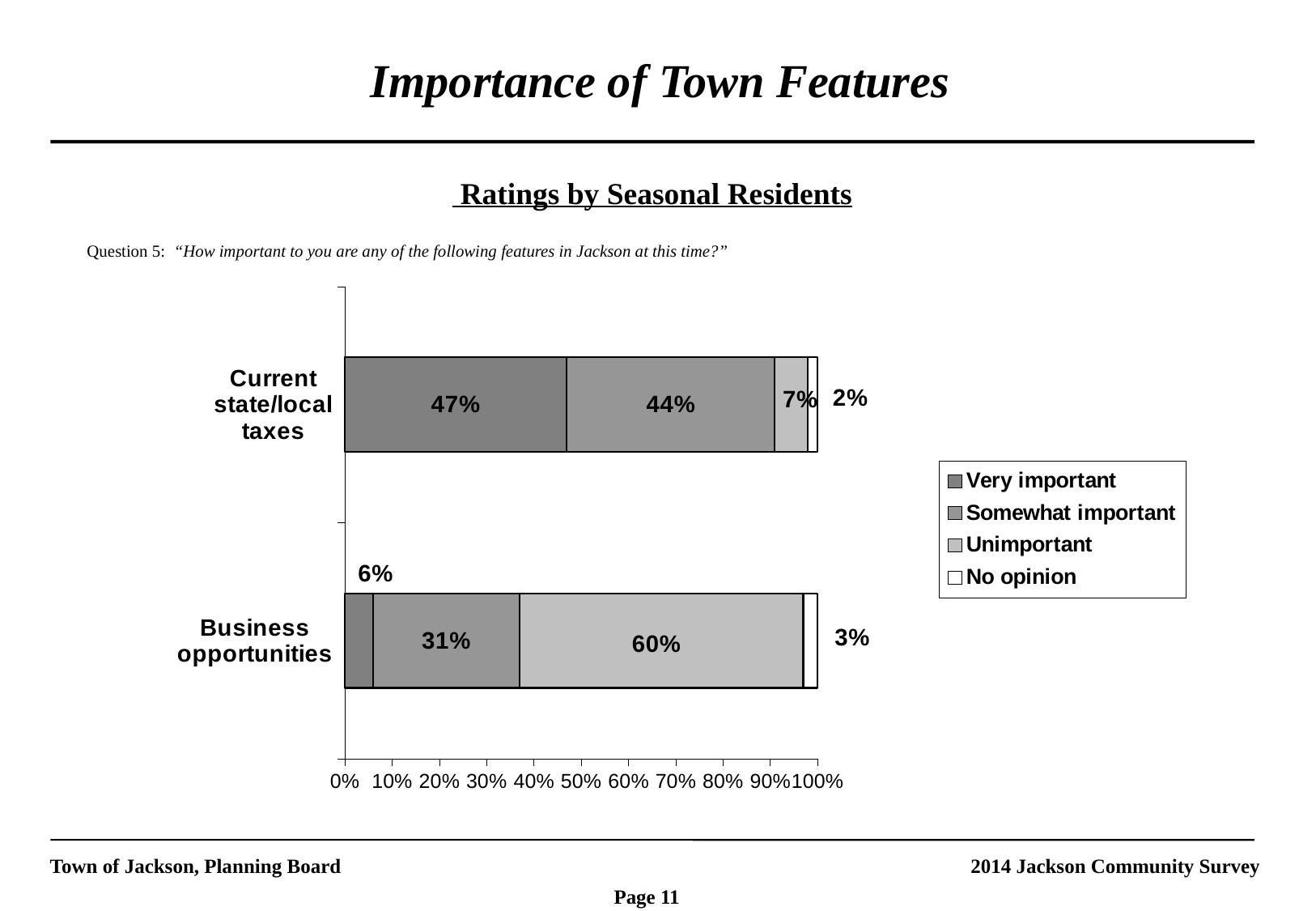
What is the difference between the 'Unimportant' percentages for business opportunities and current state/local taxes? 53% How many features (categories) are shown in the chart? 2 What is the difference between the 'Somewhat important' percentages for current state/local taxes and business opportunities? 13% What percentage of seasonal residents rated business opportunities as very important? 6% What percentage of seasonal residents had no opinion on current state/local taxes? 2% What percentage of seasonal residents rated current state/local taxes as very important? 47% Which feature has the higher 'Very important' percentage, current state/local taxes or business opportunities? Current state/local taxes How many series does the legend list? 4 What is the total of the 'Very important' and 'Somewhat important' percentages for current state/local taxes? 91% What percentage of seasonal residents rated current state/local taxes as somewhat important? 44% What type of chart is shown on the slide? Stacked bar chart What percentage of seasonal residents rated business opportunities as unimportant? 60%